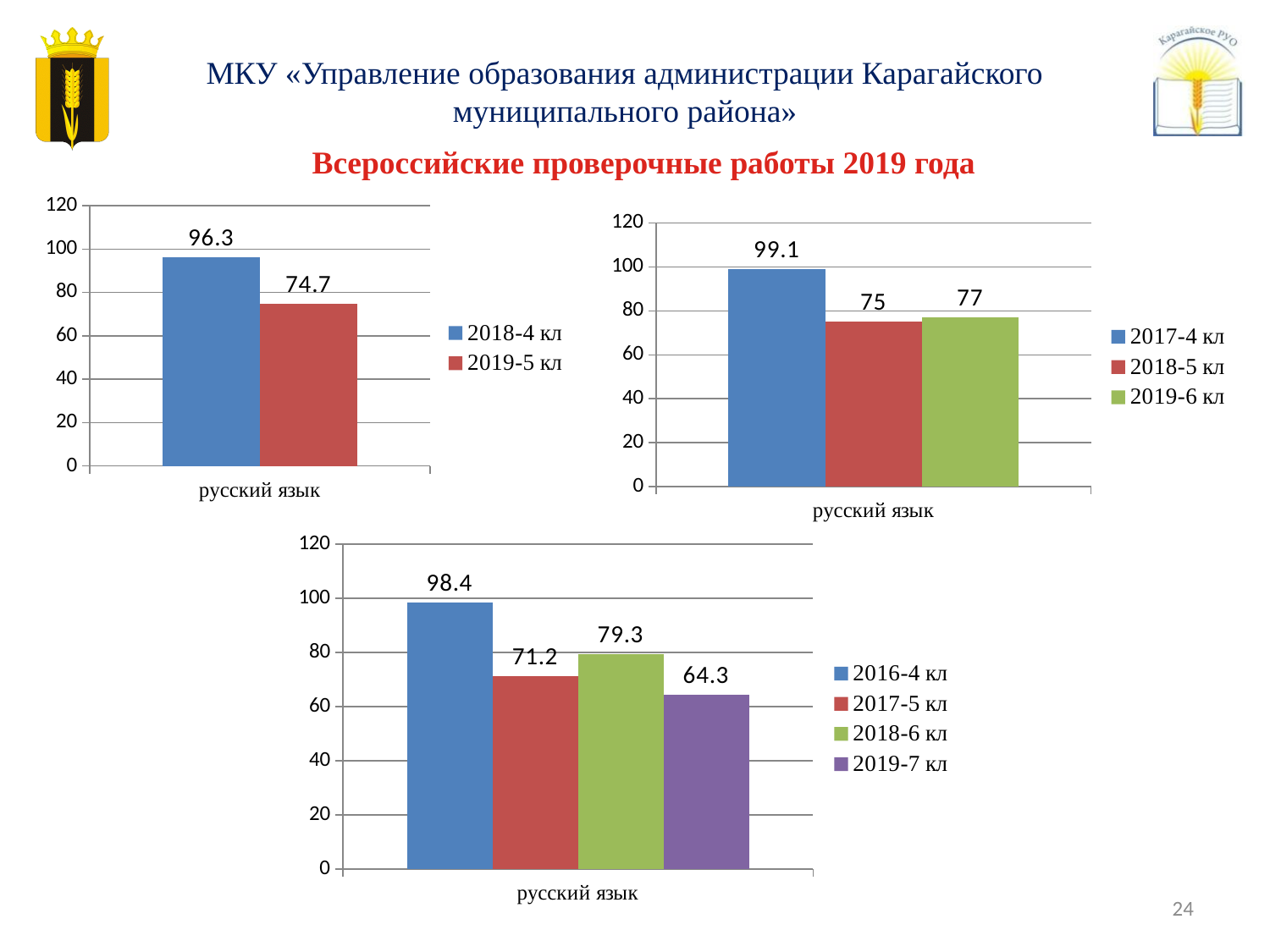
In the top-right chart, what is the value for 2017-4 кл? 99.1 What type of chart is the bottom chart? Bar chart In the top-right chart, which series has the lowest value? 2018-5 кл In the top-right chart, how many series does the legend list? 3 In the top-left chart, what is the value for 2018-4 кл? 96.3 In the bottom chart, which series has the highest value? 2016-4 кл In the bottom chart, how many series does the legend list? 4 In the top-right chart, what is the difference between the 2019-6 кл and 2018-5 кл values? 2 In the bottom chart, what is the value for 2019-7 кл? 64.3 In the bottom chart, which is larger: the value for 2017-5 кл or 2018-6 кл? 2018-6 кл In the top-left chart, what is the difference between the 2018-4 кл and 2019-5 кл values? 21.6 In the top-left chart, what is the value for 2019-5 кл? 74.7